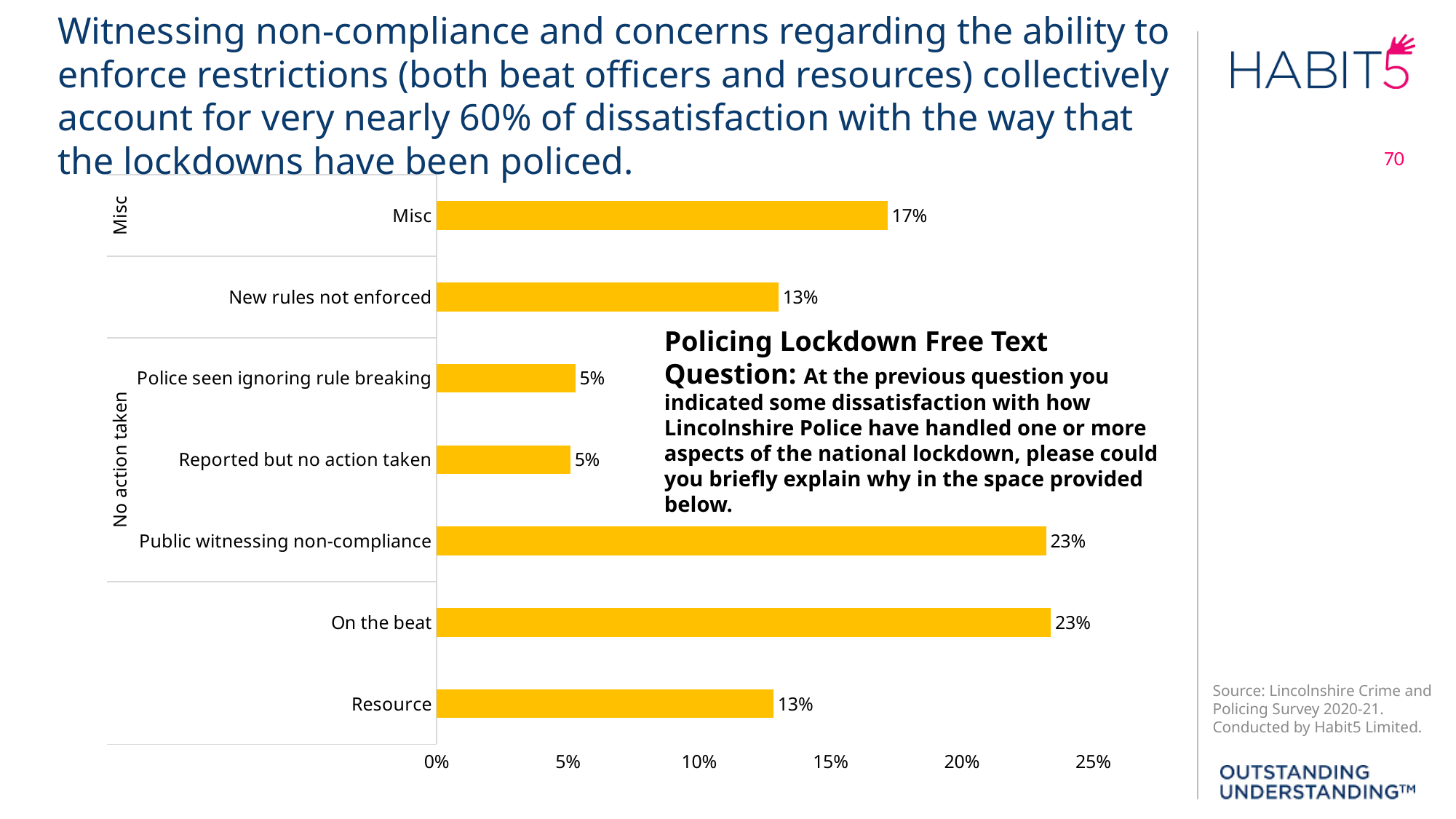
What is the value for Public witnessing non-compliance? 23% How many categories are plotted in the chart? 7 What is the value for Police seen ignoring rule breaking? 5% Which is larger, the value for On the beat or the value for New rules not enforced? On the beat What is the value for Resource? 13% Is the value for Misc greater or less than 15%? greater Which is larger, the value for Misc or the value for Resource? Misc What is the difference between the value for On the beat and the value for Reported but no action taken? 18 percentage points What is the value for Misc? 17% What is the difference between the value for Misc and the value for Resource? 4 percentage points What kind of chart is shown on the slide? Bar chart What is the value for New rules not enforced? 13%